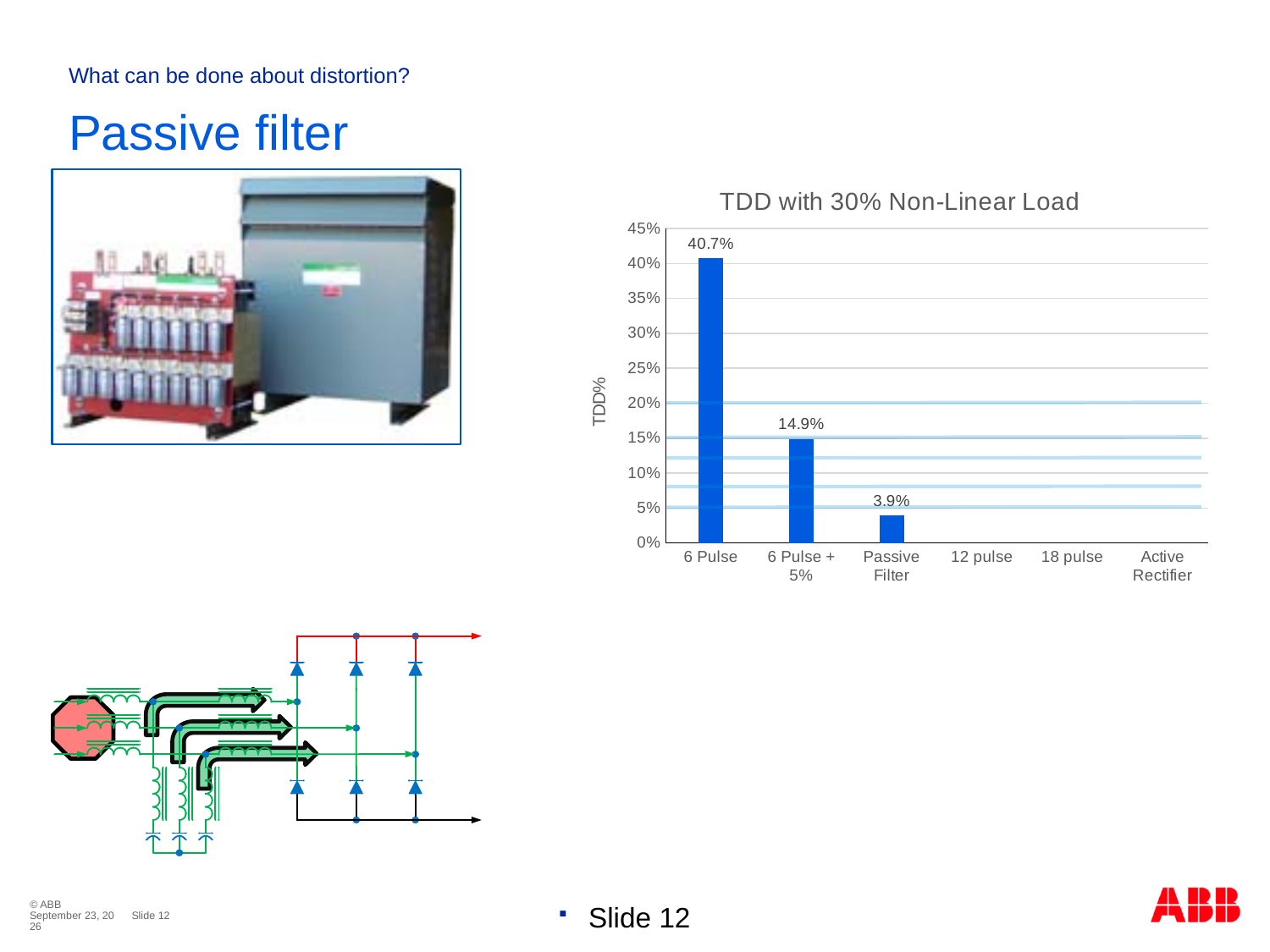
What is the difference between the TDD values for 6 Pulse and 6 Pulse + 5%? 25.8% What is the title of the chart? TDD with 30% Non-Linear Load What is the TDD value for Passive Filter? 3.9% What is the TDD value for 6 Pulse + 5%? 14.9% What type of chart is shown on the slide? bar chart Is the value for 6 Pulse + 5% greater or less than 20%? less What is the TDD value for 6 Pulse? 40.7% Which is larger, the TDD value for 6 Pulse + 5% or for Passive Filter? 6 Pulse + 5% Which category has the highest TDD value? 6 Pulse What is the difference between the TDD values for 6 Pulse + 5% and Passive Filter? 11.0% How many categories are labelled on the x axis of the chart? 6 Among the categories with plotted bars, which has the lowest TDD value? Passive Filter